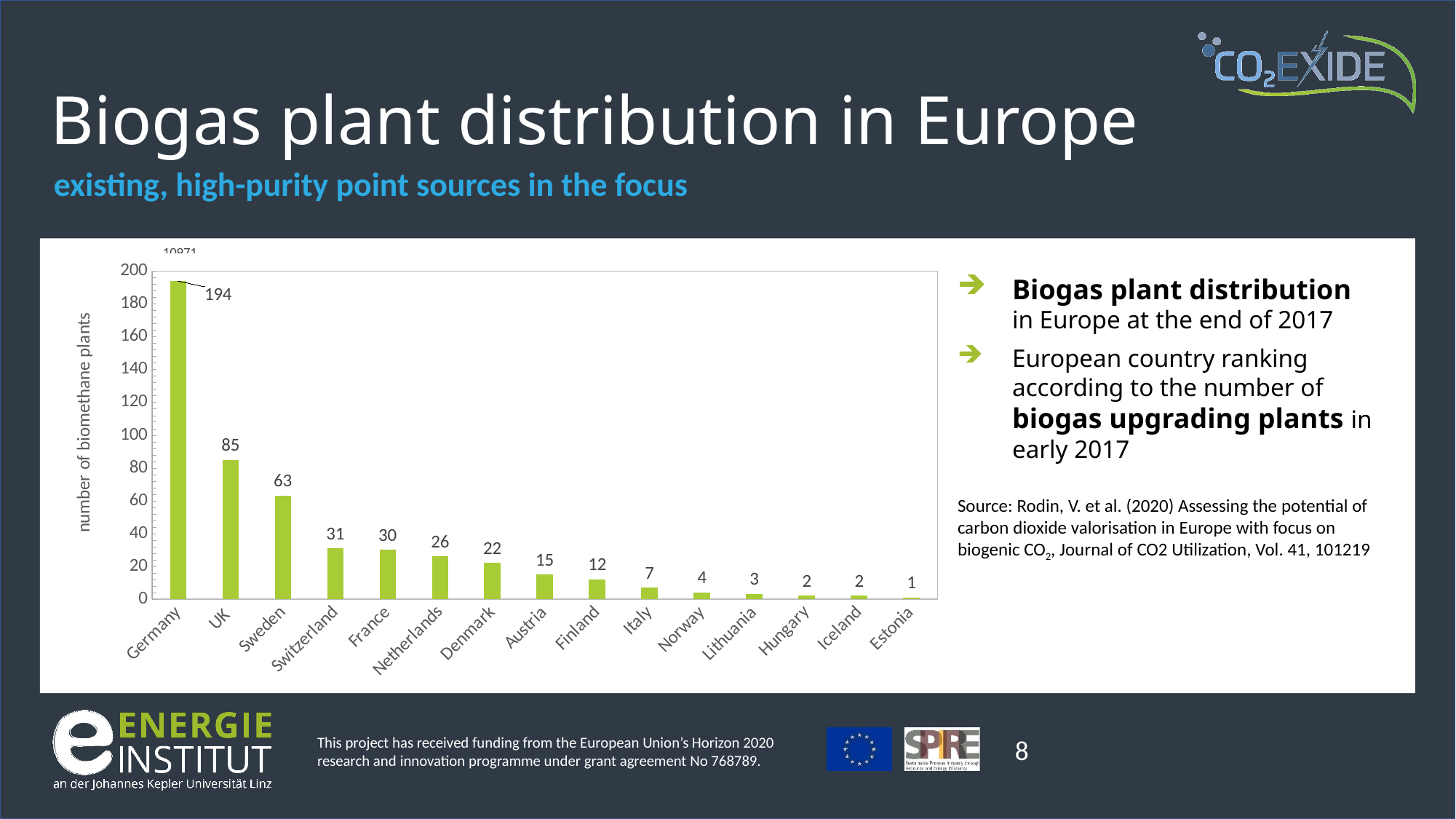
Which country has the lowest value? Estonia What is the value for Finland? 12 What is the difference between the values for Switzerland and France? 1 What is the label of the y axis? number of biomethane plants What is the difference between the values for the UK and Sweden? 22 Is the value for Germany greater or less than 180? greater Which has a larger value, Denmark or Austria? Denmark What is the value for the Netherlands? 26 What is the value for the UK? 85 What kind of chart is shown on the slide? bar chart How many countries are shown on the x axis? 15 What is the value for Sweden? 63